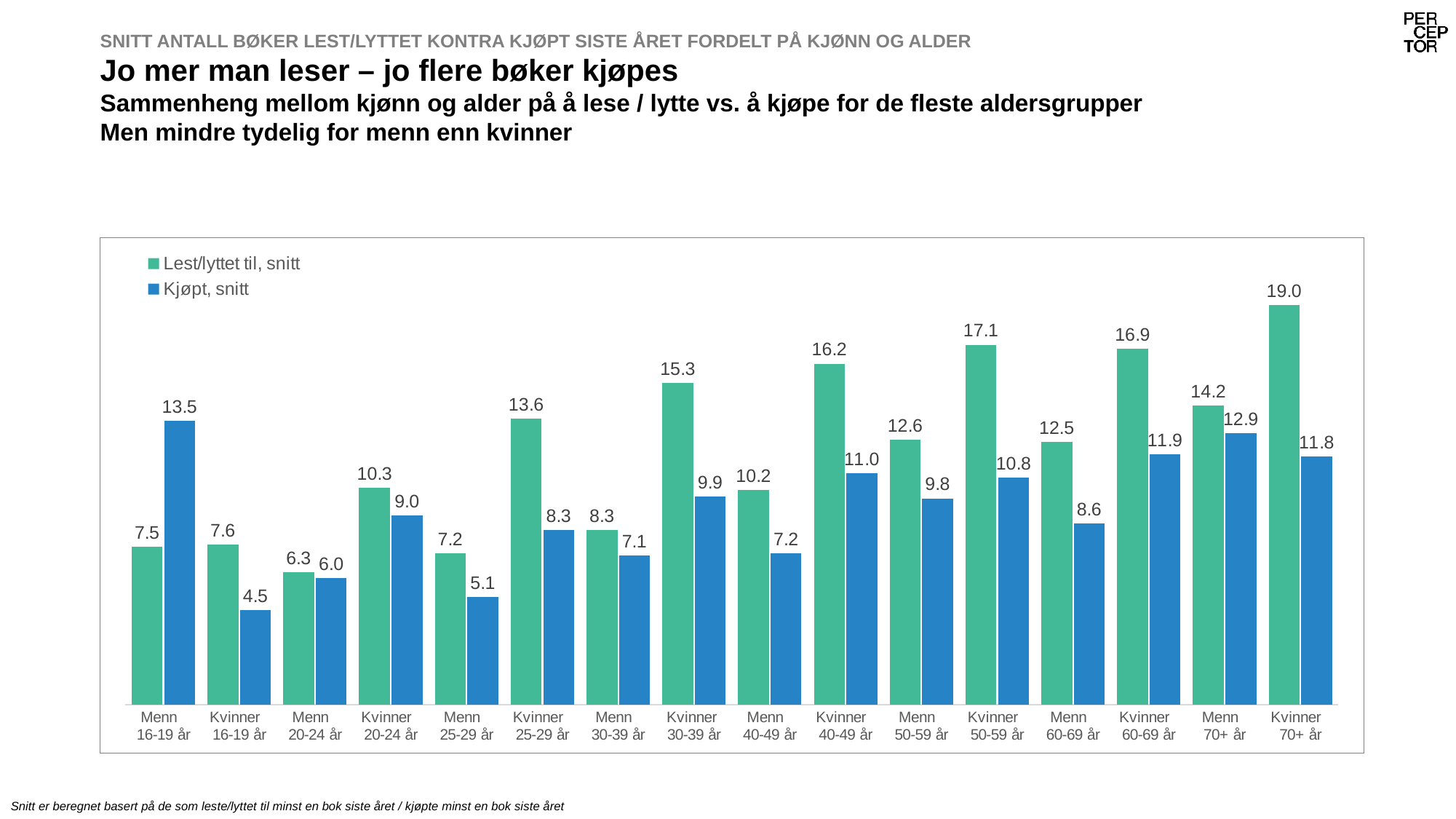
What kind of chart is shown on the slide? Bar chart What is the 'Kjøpt, snitt' value for Kvinner 40-49 år? 11.0 Which is larger for Menn 16-19 år: 'Lest/lyttet til, snitt' or 'Kjøpt, snitt'? Kjøpt, snitt Which category has the lowest 'Kjøpt, snitt' value? Kvinner 16-19 år What is the 'Kjøpt, snitt' value for Menn 16-19 år? 13.5 How many series does the legend list? 2 Which category has the highest 'Lest/lyttet til, snitt' value? Kvinner 70+ år What is the difference between the 'Lest/lyttet til, snitt' and 'Kjøpt, snitt' values for Kvinner 50-59 år? 6.3 Which is larger for Menn 70+ år: 'Lest/lyttet til, snitt' or 'Kjøpt, snitt'? Lest/lyttet til, snitt How many categories are shown on the x axis? 16 Which colour represents the 'Kjøpt, snitt' series? Blue What is the 'Lest/lyttet til, snitt' value for Kvinner 70+ år? 19.0